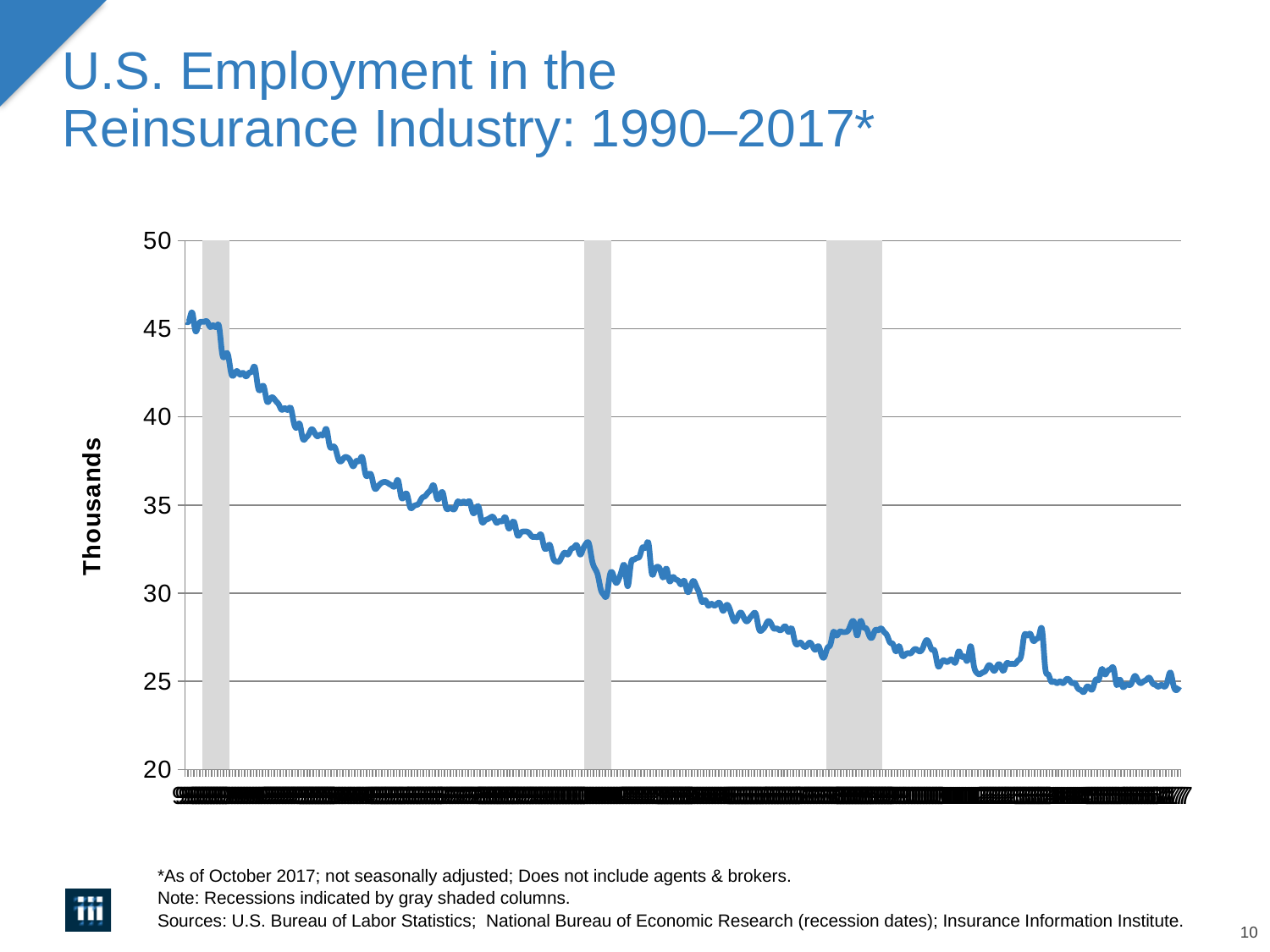
What is the lowest value shown on the vertical axis of the chart? 20 What kind of chart is shown on the slide? line chart Is the value at the end of the line (right end) greater or less than 20? greater What is the title of the chart on the slide? U.S. Employment in the Reinsurance Industry: 1990–2017* What is the label on the vertical axis of the chart? Thousands Is the value at the start of the line (left end) greater or less than 40? greater Do the values in the chart generally rise or fall from left to right along the x axis? fall Is the value at the end of the line (right end) greater or less than 30? less